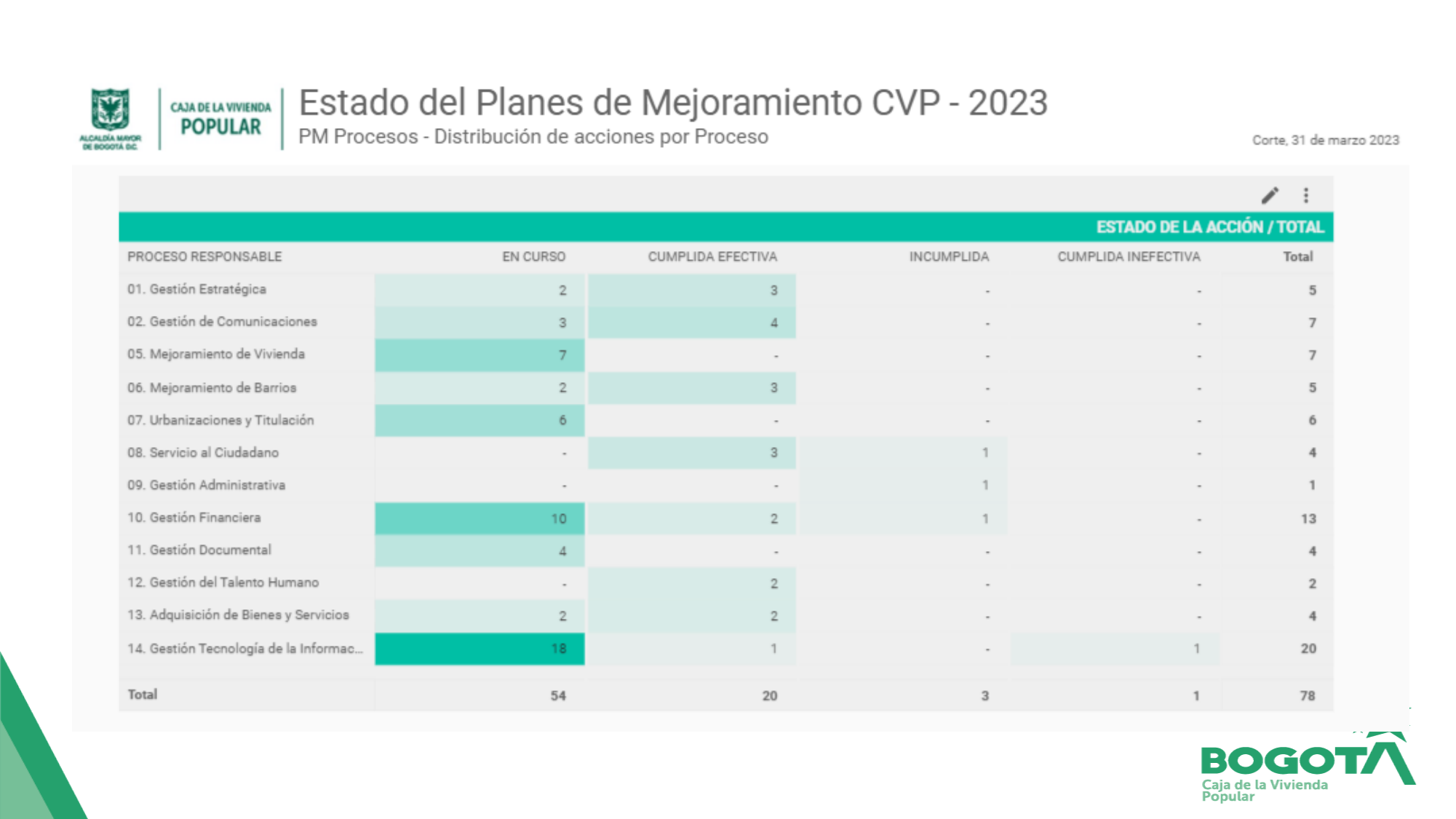
What is the total number of 'Cumplida efectiva' actions across all processes? 20 How many actions are 'En curso' for 14. Gestión Tecnología de la Informac...? 18 What is the overall total of actions across all processes? 78 Which process has the lowest total number of actions? 09. Gestión Administrativa How many 'Cumplida efectiva' actions does 02. Gestión de Comunicaciones have? 4 Which process has the highest total number of actions? 14. Gestión Tecnología de la Informac... Which process has the only 'Cumplida inefectiva' action? 14. Gestión Tecnología de la Informac... How many action status columns (excluding Total) does the table show? 4 How many processes are listed in the table? 12 What is the total number of actions for 10. Gestión Financiera? 13 Which has more 'En curso' actions: 05. Mejoramiento de Vivienda or 07. Urbanizaciones y Titulación? 05. Mejoramiento de Vivienda What is the difference between the 'En curso' values for 14. Gestión Tecnología de la Informac... and 10. Gestión Financiera? 8